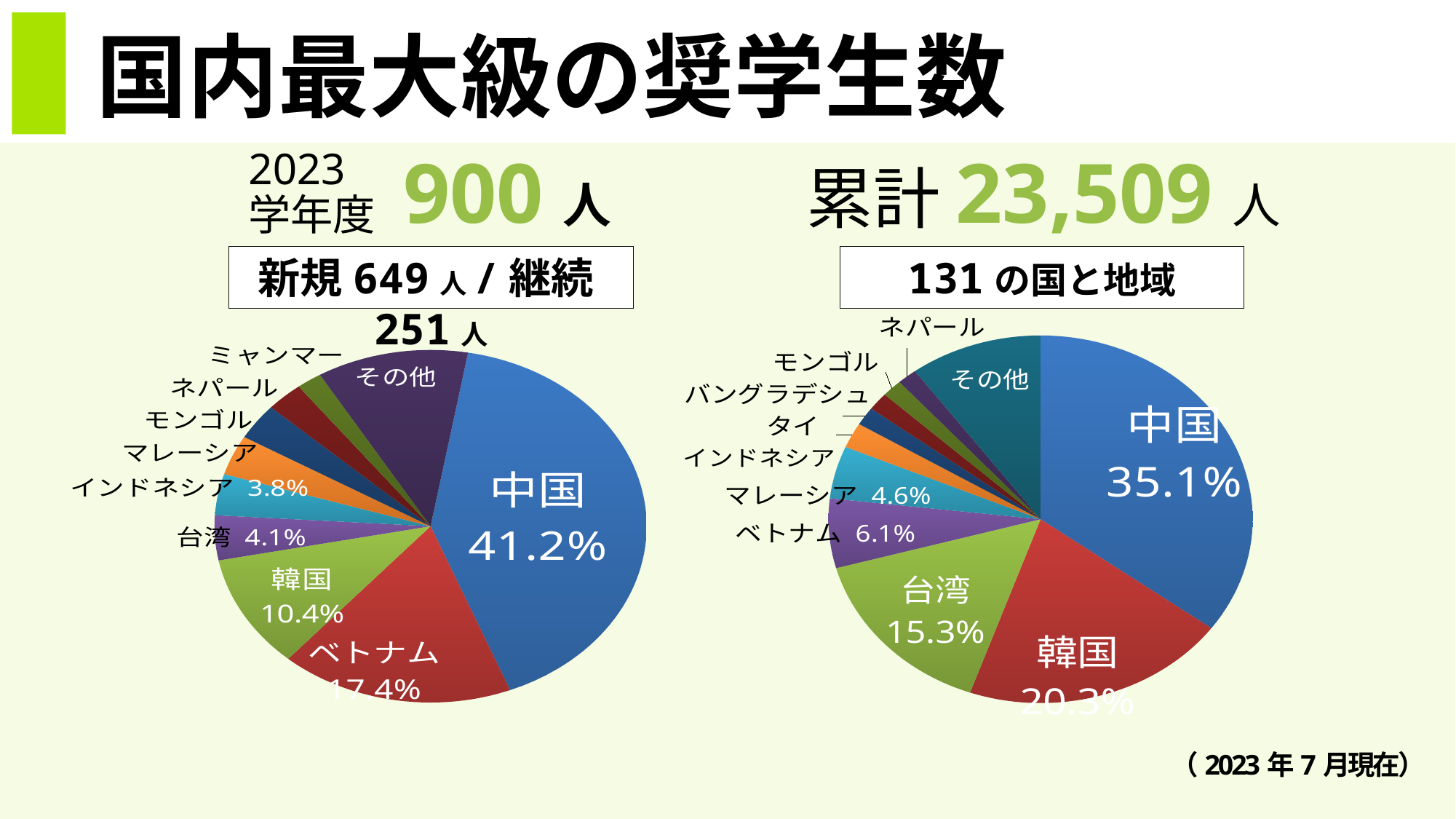
In the right pie chart (累計), what is the difference in percentage points between the shares of 韓国 and ベトナム? 14.2 What is the cumulative total number of scholarship students (累計) shown above the right pie chart? 23,509 人 In the left pie chart (2023学年度), what percentage share does ベトナム have? 17.4% In the left pie chart (2023学年度), what percentage share does 韓国 have? 10.4% In the right pie chart (累計), what percentage share does マレーシア have? 4.6% In the left pie chart (2023学年度), which is larger, the share of 台湾 or the share of インドネシア? 台湾 What type of chart is used on the left side of the slide (2023学年度)? Pie chart In the right pie chart (累計), which country has the largest share? 中国 In the right pie chart (累計), what percentage share does 台湾 have? 15.3% In the right pie chart (累計), what percentage share does 中国 have? 35.1% How many labelled slices does the right pie chart (累計) have? 11 In the left pie chart (2023学年度), what percentage share does 中国 have? 41.2%